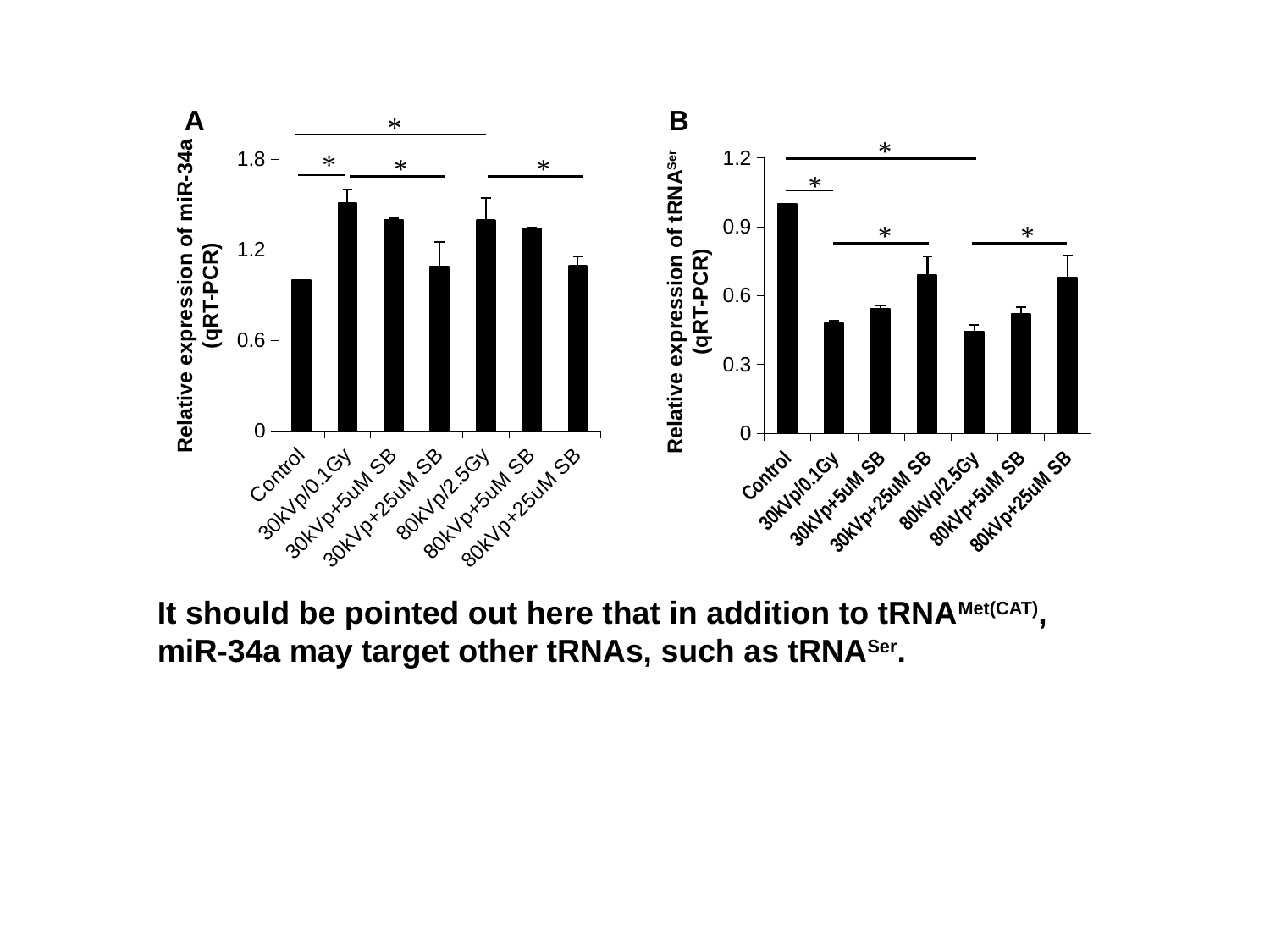
In chart A (Relative expression of miR-34a), which category has the lowest bar? Control In chart A (Relative expression of miR-34a), which is larger, the value for 30kVp/0.1Gy or the value for 30kVp+25uM SB? 30kVp/0.1Gy What kind of chart is chart A (Relative expression of miR-34a)? bar chart In chart B (Relative expression of tRNASer), is the value for 30kVp+25uM SB greater or less than 0.6? greater In chart A (Relative expression of miR-34a), which category has the highest bar? 30kVp/0.1Gy In chart A (Relative expression of miR-34a), is the value for Control greater or less than 1.2? less In chart B (Relative expression of tRNASer), which category has the highest bar? Control In chart B (Relative expression of tRNASer), which is larger, the value for Control or the value for 30kVp/0.1Gy? Control In chart A (Relative expression of miR-34a), is the value for 30kVp/0.1Gy greater or less than 1.2? greater How many categories are shown on the x axis of chart B (Relative expression of tRNASer)? 7 What is the y-axis title of chart A? Relative expression of miR-34a (qRT-PCR)